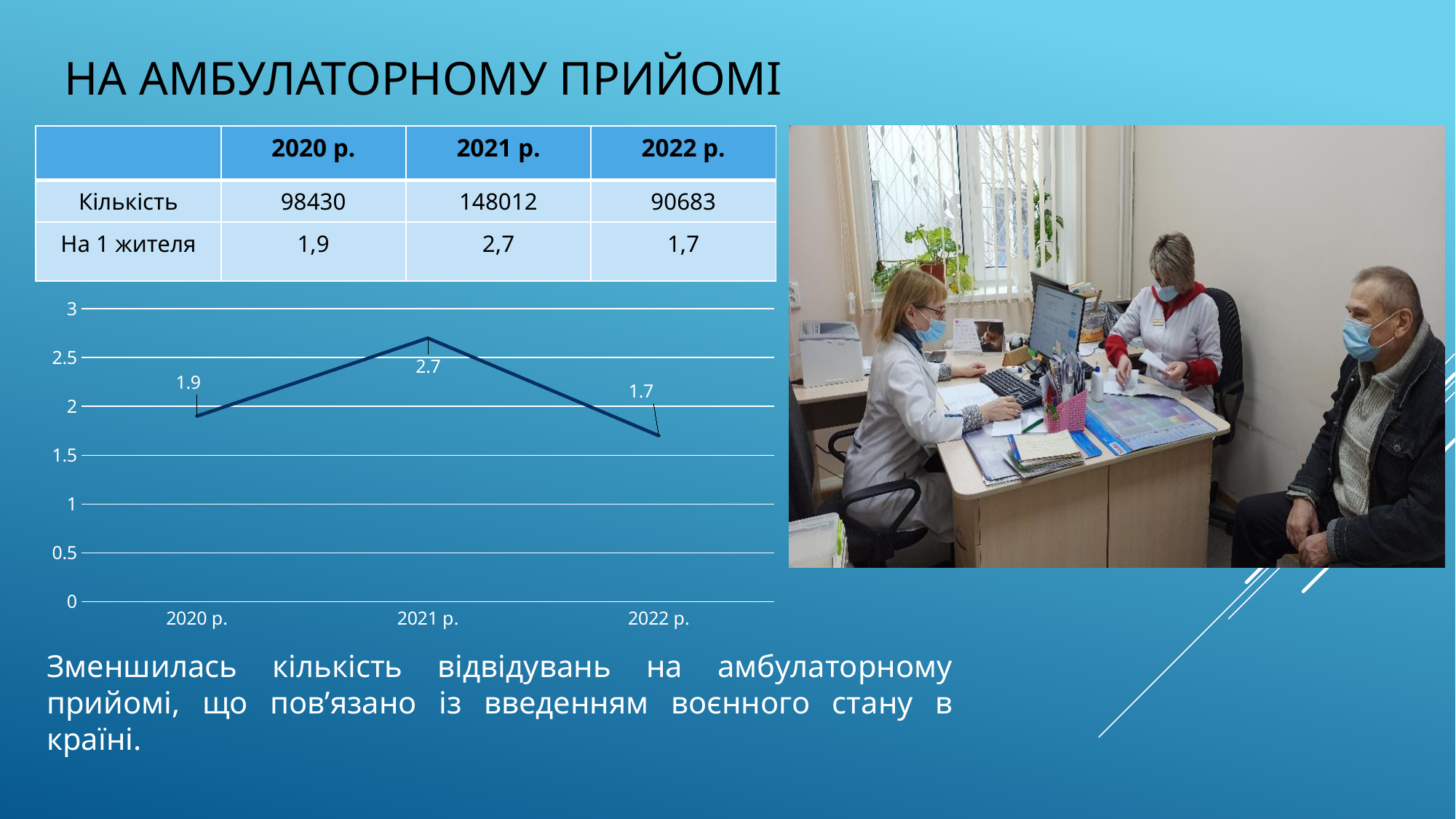
Which is larger in the line chart, the value for 2020 р. or the value for 2022 р.? 2020 р. What type of chart is shown on the slide? line chart What is the value plotted for 2021 р. in the line chart? 2.7 Is the value for 2021 р. in the line chart greater or less than 2.5? greater What is the difference between the values for 2021 р. and 2022 р. in the line chart? 1 How many data points are plotted in the line chart? 3 What is the value plotted for 2020 р. in the line chart? 1.9 Which year has the highest value in the line chart? 2021 р. What is the difference between the values for 2021 р. and 2020 р. in the line chart? 0.8 Does the value in the line chart rise or fall from 2021 р. to 2022 р.? fall Which year has the lowest value in the line chart? 2022 р. What is the value plotted for 2022 р. in the line chart? 1.7